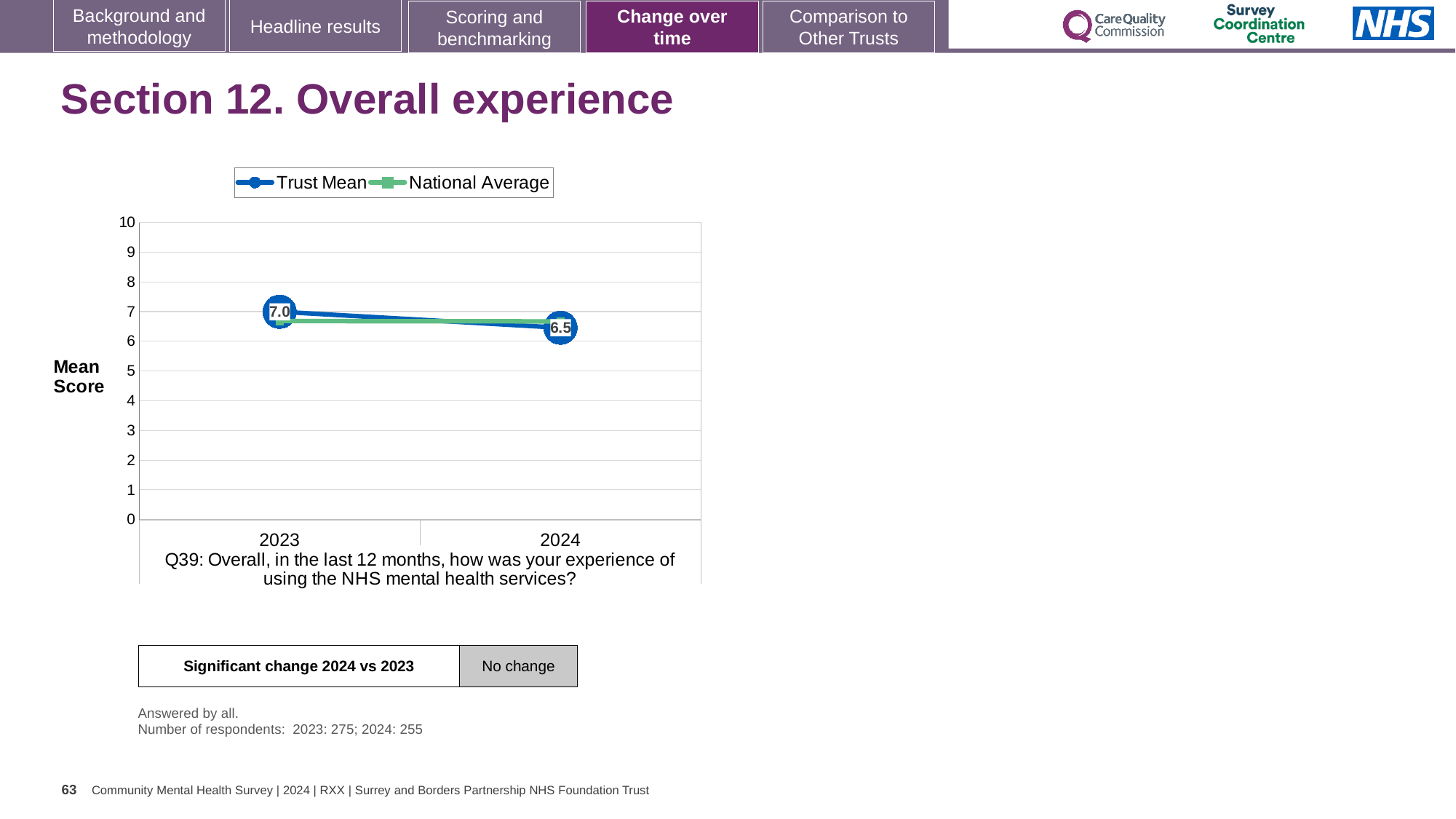
How many years are plotted on the x axis? 2 In which year is the Trust Mean higher? 2023 By how much did the Trust Mean change from 2023 to 2024? 0.5 Does the Trust Mean rise or fall from 2023 to 2024? fall What is the Trust Mean value for 2023? 7.0 What kind of chart is shown? line chart In 2023, which is larger, the Trust Mean or the National Average? Trust Mean How many series does the legend list? 2 What is the label on the y axis of the chart? Mean Score What is the Trust Mean value for 2024? 6.5 Is the National Average value for 2023 greater or less than 5? greater Which is larger, the Trust Mean for 2023 or the Trust Mean for 2024? 2023